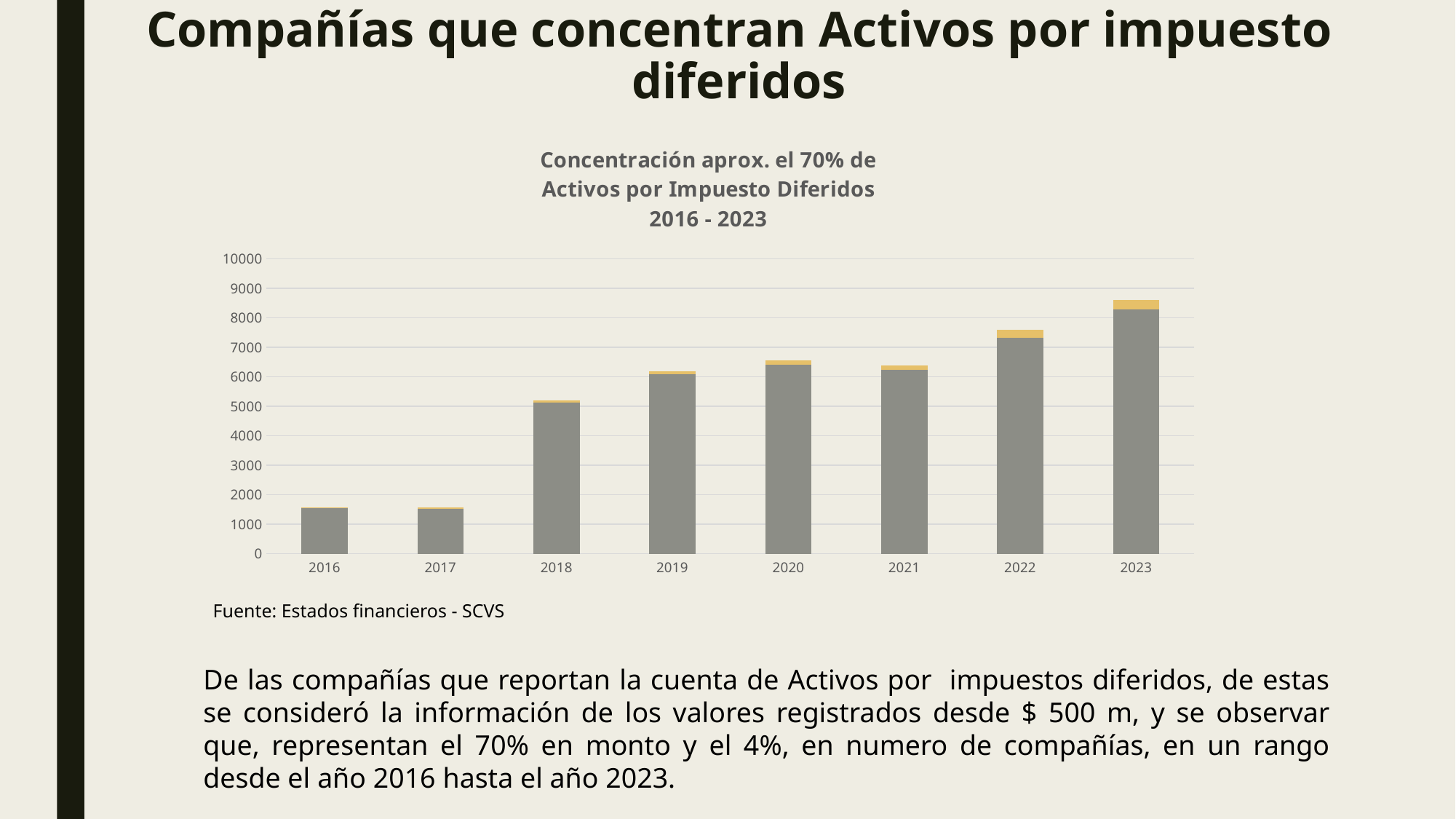
Is the value for 2023 greater or less than 8000? greater Is the value for 2016 greater or less than 2000? less What is the maximum value shown on the vertical axis of the chart? 10000 How many years are shown on the x axis of the chart? 8 Which is larger, the value for 2018 or the value for 2019? 2019 Is the value for 2022 greater or less than 7000? greater Do the values generally rise or fall from 2016 to 2023? rise Which year has the highest bar in the chart? 2023 What is the title of the chart? Concentración aprox. el 70% de Activos por Impuesto Diferidos 2016 - 2023 What kind of chart is shown on the slide? Bar chart